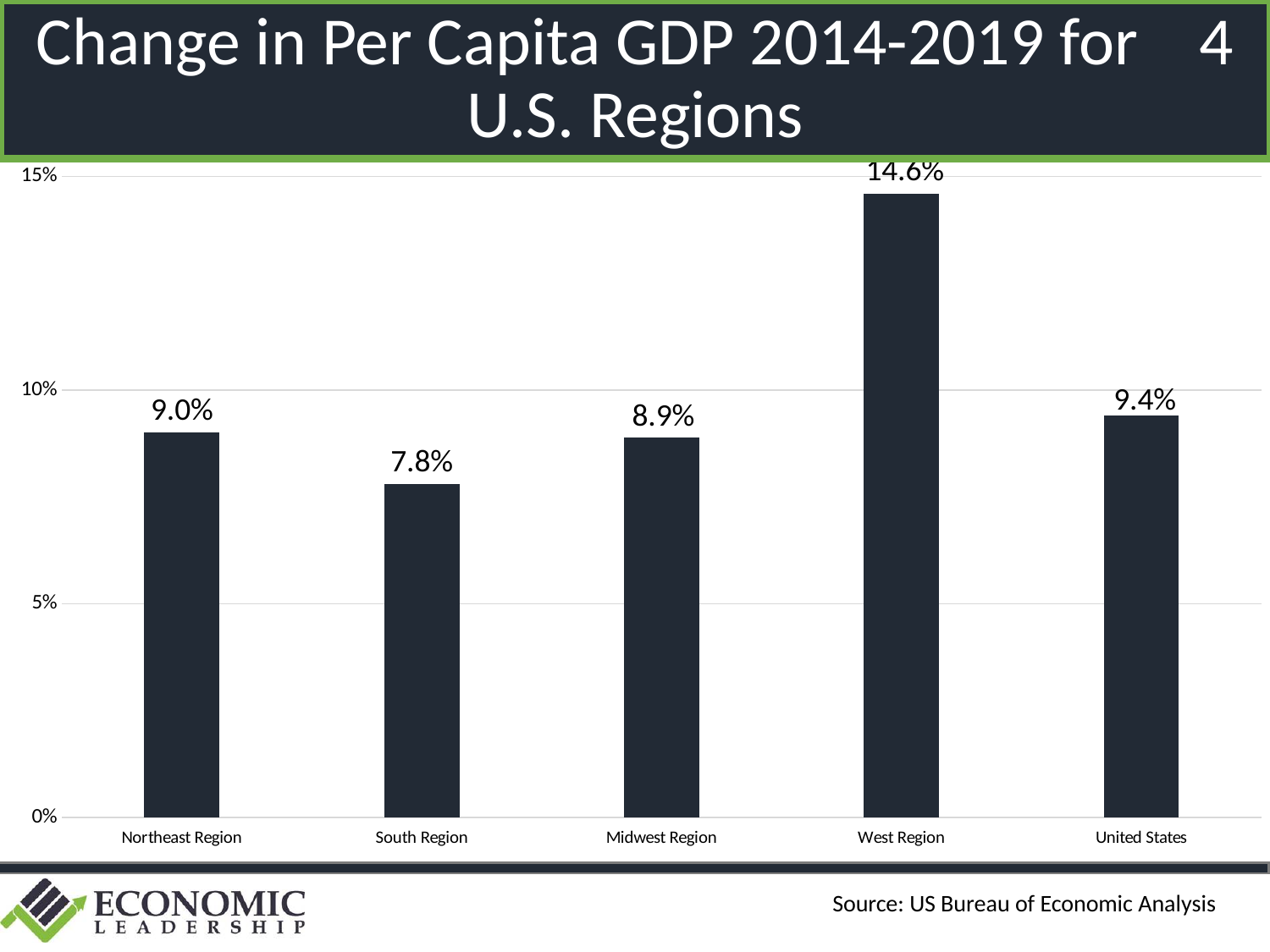
Which region has the highest change in per capita GDP? West Region What is the change in per capita GDP for the West Region? 14.6% What kind of chart is shown on the slide? Bar chart What is the value shown for the United States? 9.4% Which is larger, the value for the Northeast Region or the Midwest Region? Northeast Region How many categories are shown on the x axis? 5 Is the value for the West Region greater or less than 10%? greater Which category has the lowest change in per capita GDP? South Region What is the difference between the United States value and the Northeast Region value? 0.4% What is the title of the chart? Change in Per Capita GDP 2014-2019 for U.S. Regions What is the change in per capita GDP for the South Region? 7.8% What is the difference between the West Region and the South Region values? 6.8%